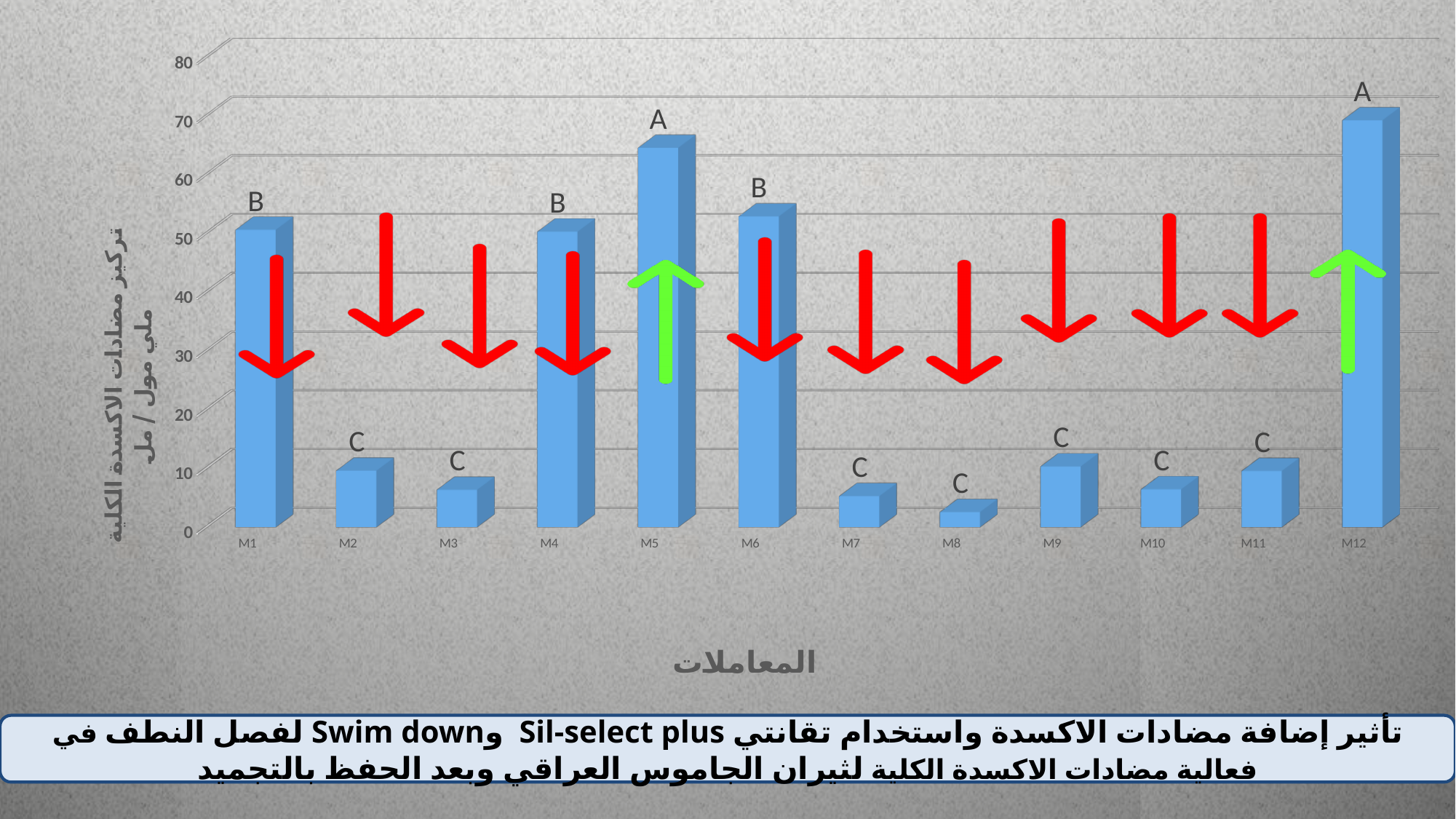
What letter is printed above the bar for M5? A Which category has the highest bar? M12 How many categories (treatments) are plotted along the x axis? 12 Is the value for M2 greater or less than 20? less Which has the larger value, M9 or M8? M9 Which category has the lowest bar? M8 Is the value for M8 greater or less than 10? less Which has the larger value, M5 or M1? M5 Is the value for M1 greater or less than 40? greater How many green upward arrows are drawn on the chart? 2 What kind of chart is shown on the slide? bar chart